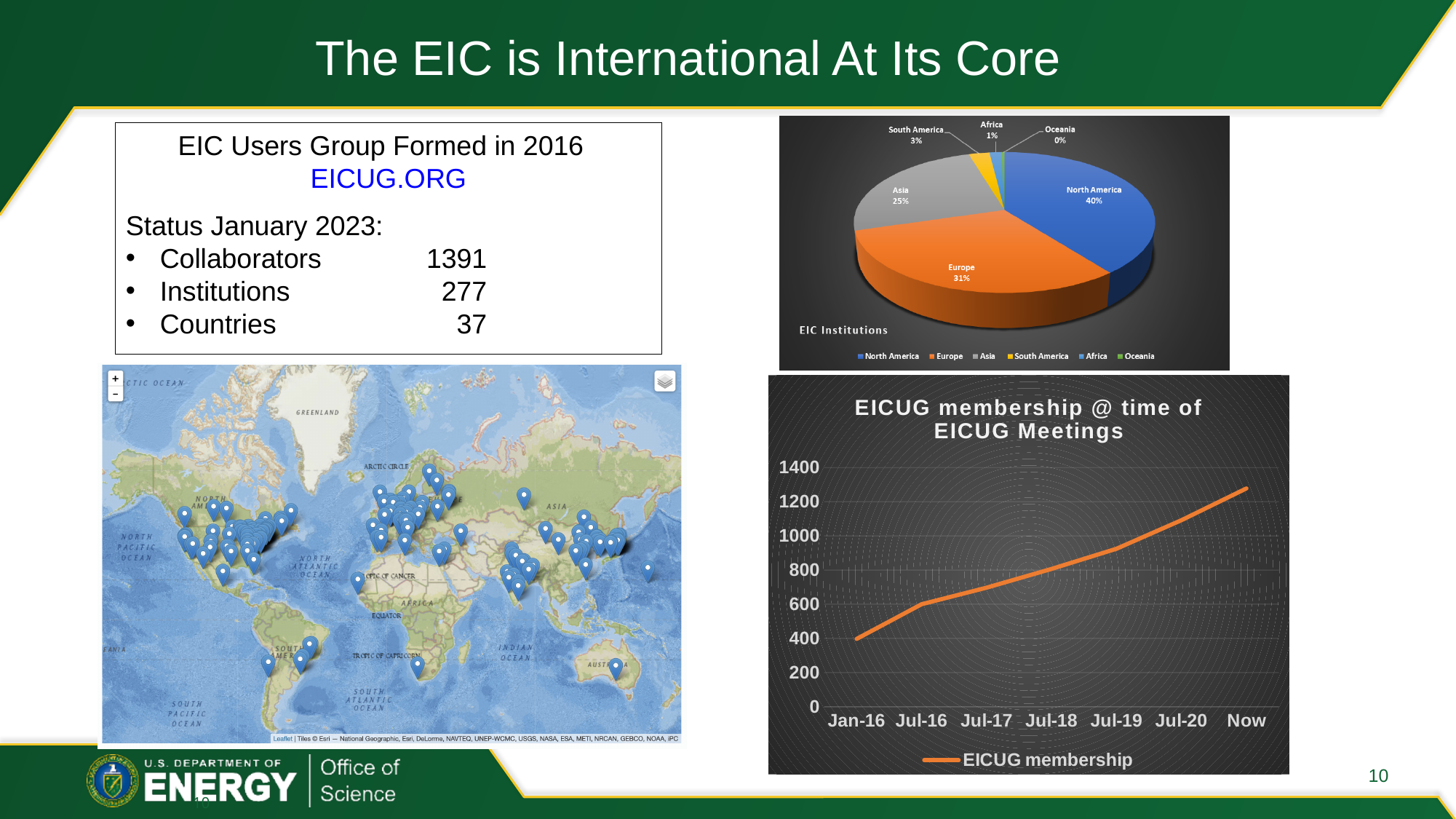
In the EIC Institutions pie chart, which region has the largest share? North America In the 'EICUG membership @ time of EICUG Meetings' chart, is the value for Now greater or less than 1200? greater In the EIC Institutions pie chart, what share of institutions is from Europe? 31% What kind of chart is the EIC Institutions chart? Pie chart In the EIC Institutions pie chart, what is the difference in percentage points between the Europe and Asia shares? 6 In the EIC Institutions pie chart, what share of institutions is from Asia? 25% In the EIC Institutions pie chart, how many regions are shown in the legend? 6 What kind of chart is the 'EICUG membership @ time of EICUG Meetings' chart? Line chart In the 'EICUG membership @ time of EICUG Meetings' chart, does membership rise or fall from Jan-16 to Now? Rise In the EIC Institutions pie chart, which region has the smallest share? Oceania In the EIC Institutions pie chart, what share of institutions is from North America? 40% In the 'EICUG membership @ time of EICUG Meetings' chart, is the value for Jul-17 greater or less than 800? less